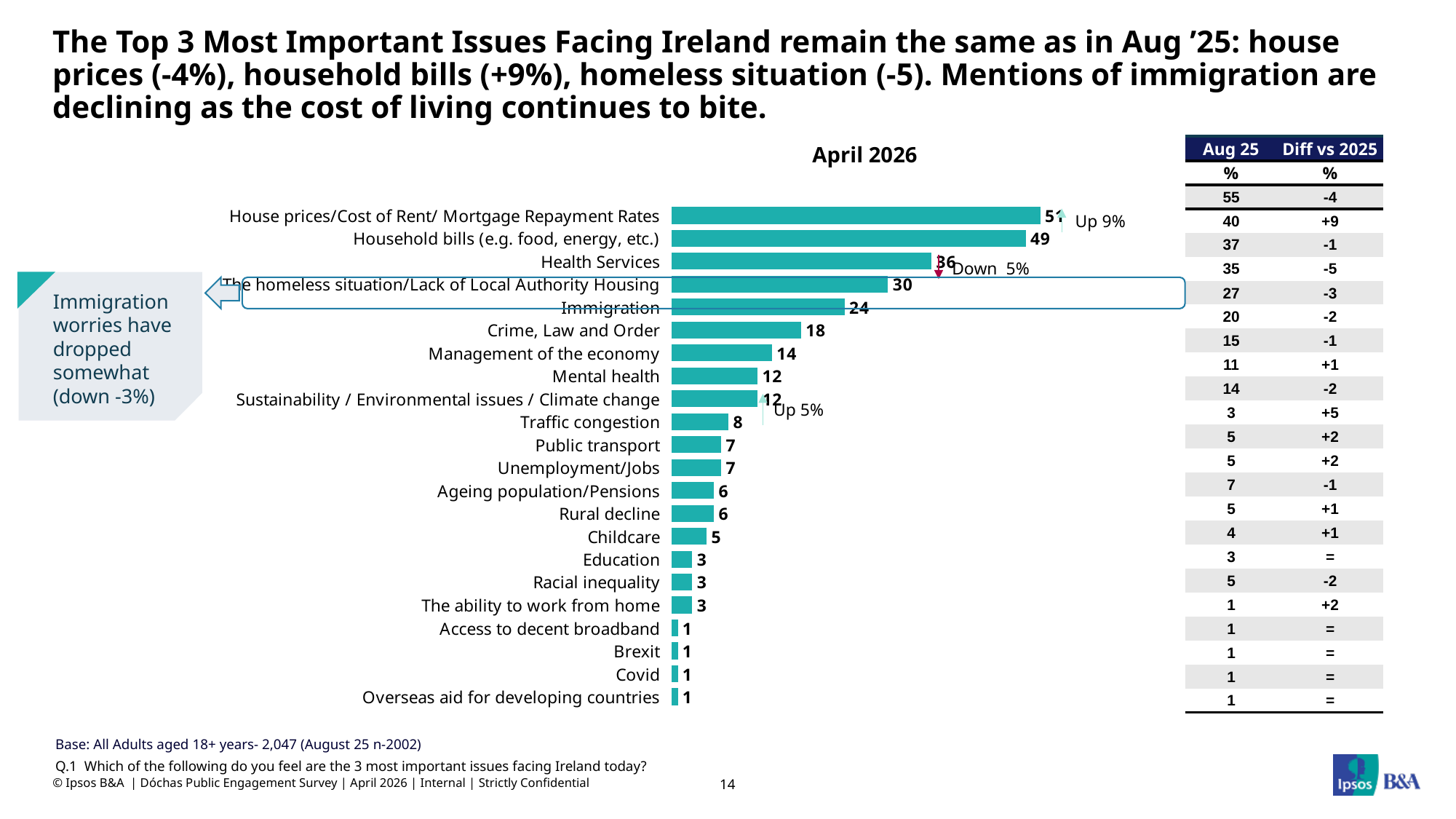
What is the title of the chart? April 2026 What kind of chart is shown on the slide? bar chart What is the value for The homeless situation/Lack of Local Authority Housing? 30 What is the difference between the values for Household bills and Immigration? 25 What is the value for Traffic congestion? 8 What is the value for Household bills (e.g. food, energy, etc.) in the April 2026 chart? 49 What is the lowest value shown in the April 2026 chart? 1 How many categories are plotted in the April 2026 chart? 22 What is the value for Crime, Law and Order? 18 Which category has the highest value in the April 2026 chart? House prices/Cost of Rent/ Mortgage Repayment Rates Which is larger: the value for Immigration or the value for Crime, Law and Order? Immigration What is the value for Immigration in the April 2026 chart? 24